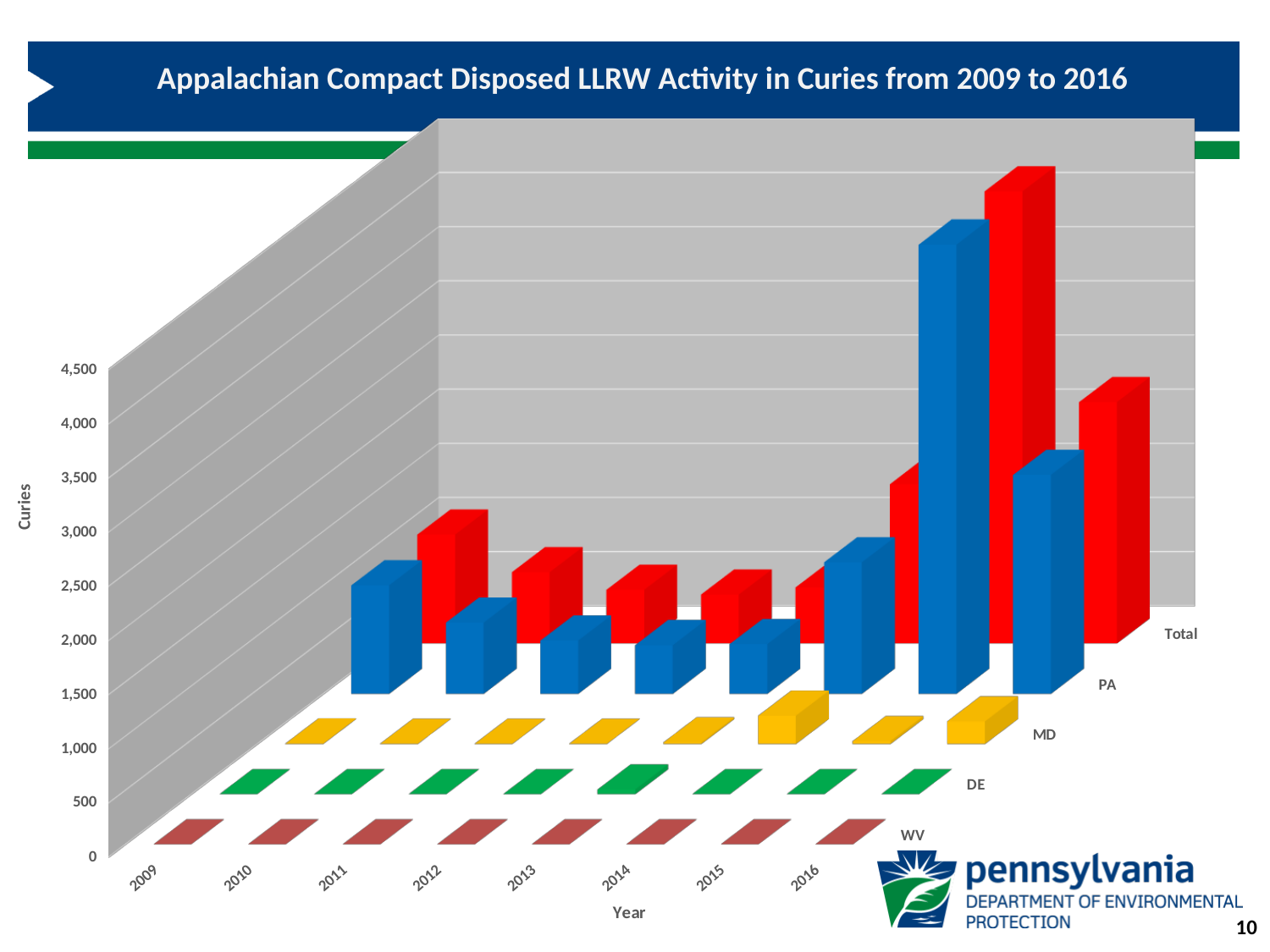
What is the label of the vertical axis? Curies Which series has the smallest values across all years? WV How many years are shown along the x axis of the chart? 8 In which year is the PA disposed activity highest? 2015 Is the Total for 2015 larger or smaller than the Total for 2016? larger How many data series (WV, DE, MD, PA, Total) does the chart plot? 5 In which year is the Total disposed activity highest? 2015 What is the title of the chart? Appalachian Compact Disposed LLRW Activity in Curies from 2009 to 2016 Which series contributes most to the Total in every year, PA or MD? PA Which is larger, the PA value in 2015 or the PA value in 2009? 2015 Is the Total value for 2015 greater or less than 3,000? greater What kind of chart is shown on the slide? bar chart